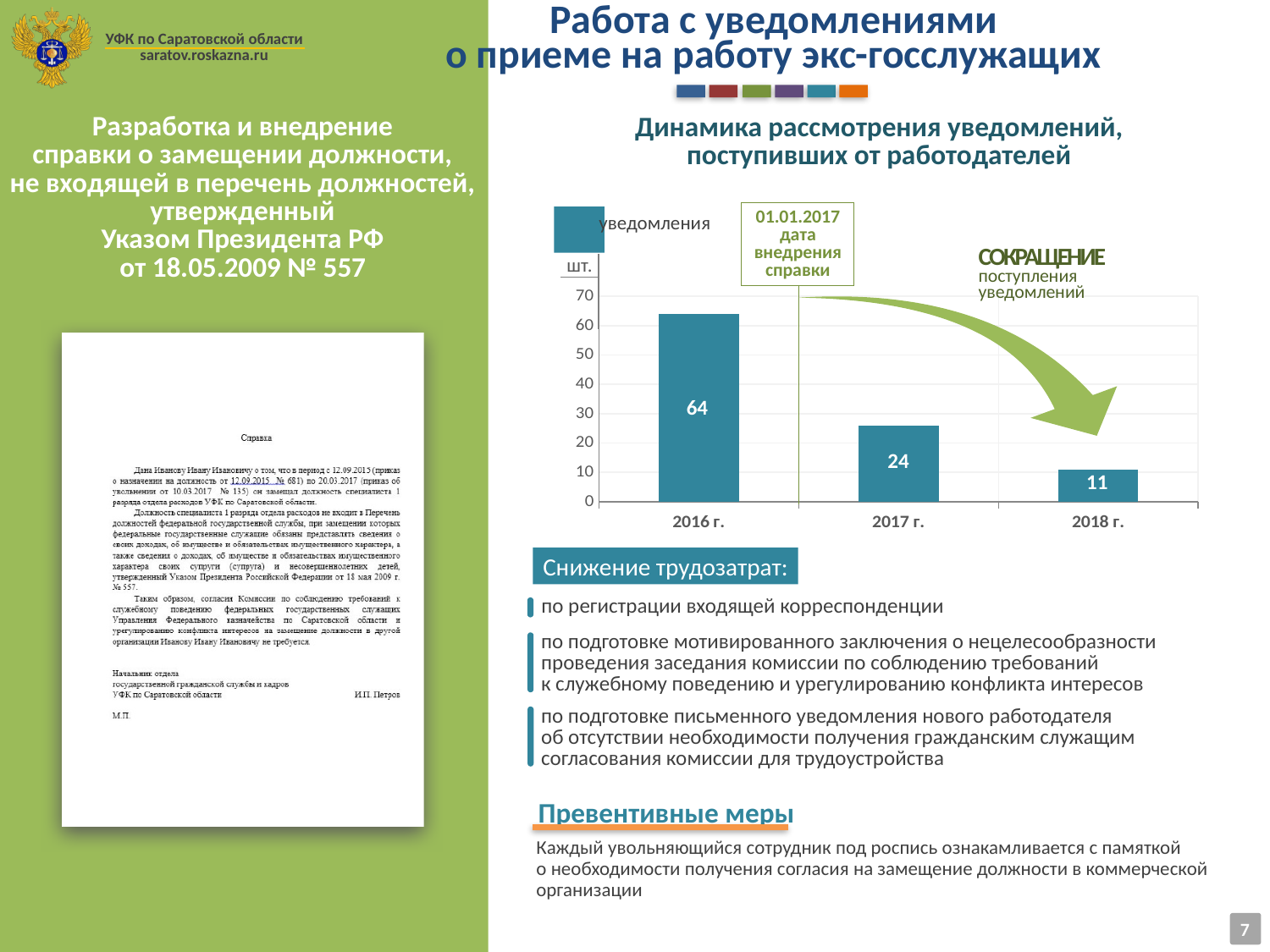
What is the value for 2018 г. in the chart? 11 How many series does the chart legend list? 1 Which year has the lowest value in the chart? 2018 г. Which year has the highest value in the chart? 2016 г. What kind of chart is shown on the slide? bar chart Which is larger, the value for 2017 г. or the value for 2018 г.? 2017 г. What is the difference between the values for 2016 г. and 2017 г.? 40 What is the difference between the values for 2017 г. and 2018 г.? 13 Do the values rise or fall from 2016 г. to 2018 г.? fall What is the value for 2017 г. in the chart? 24 What is the value for 2016 г. in the chart? 64 How many years are shown on the x axis of the chart? 3